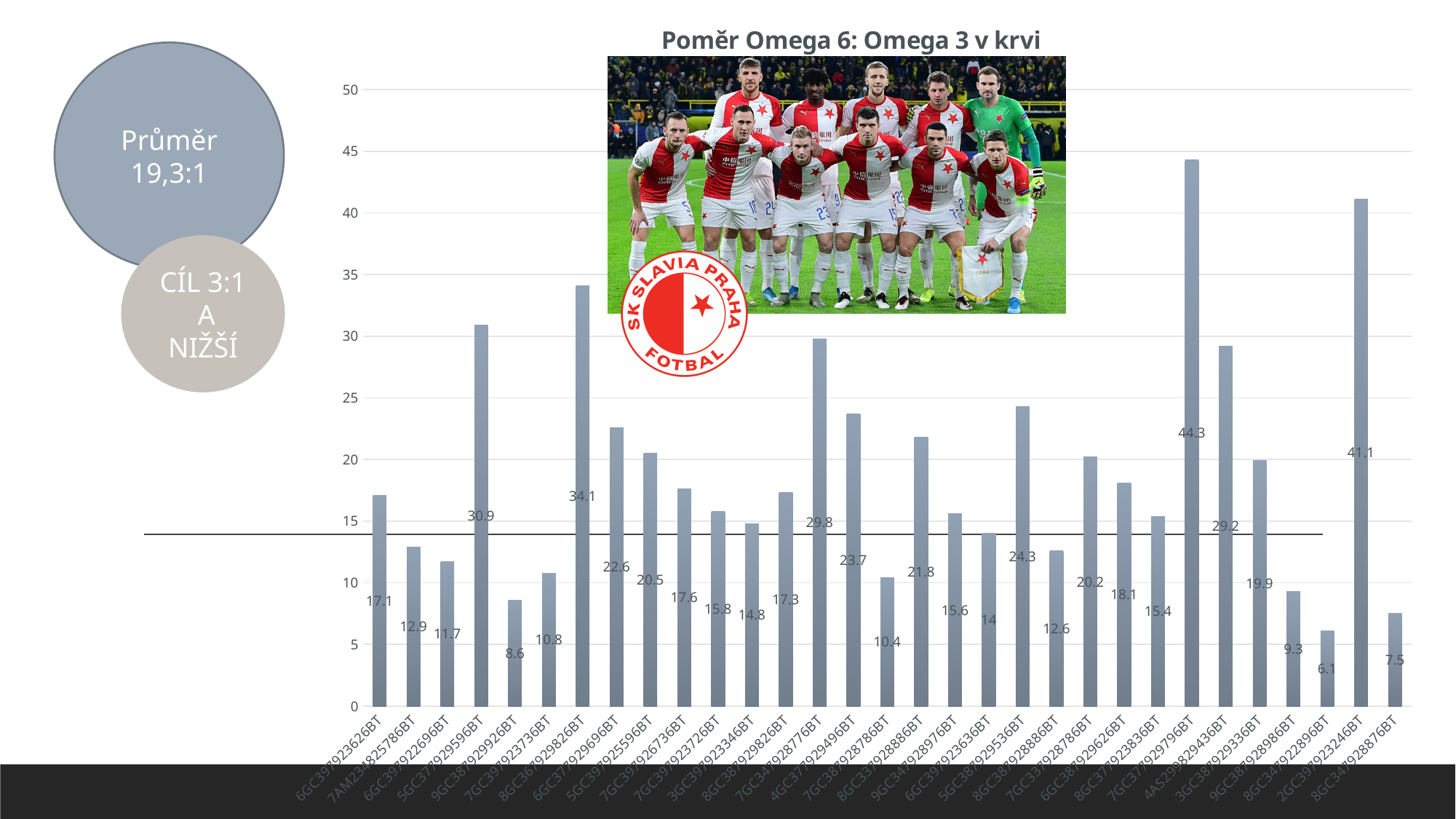
What average value is stated in the large circle on the left of the slide? 19,3:1 What is the difference between the two tallest bars, 44.3 and 41.1? 3.2 What is the value of the first (leftmost) bar in the chart? 17.1 Which is larger, the bar labelled 34.1 or the bar labelled 30.9? 34.1 What is the highest value shown in the chart? 44.3 What is the title of the chart? Poměr Omega 6: Omega 3 v krvi Is the value of the first (leftmost) bar greater or less than 15? greater What kind of chart is shown on the slide? bar chart What is the lowest value shown in the chart? 6.1 How many bars are plotted in the chart? 31 What is the value of the last (rightmost) bar in the chart? 7.5 What is the difference between the highest value (44.3) and the lowest value (6.1) in the chart? 38.2